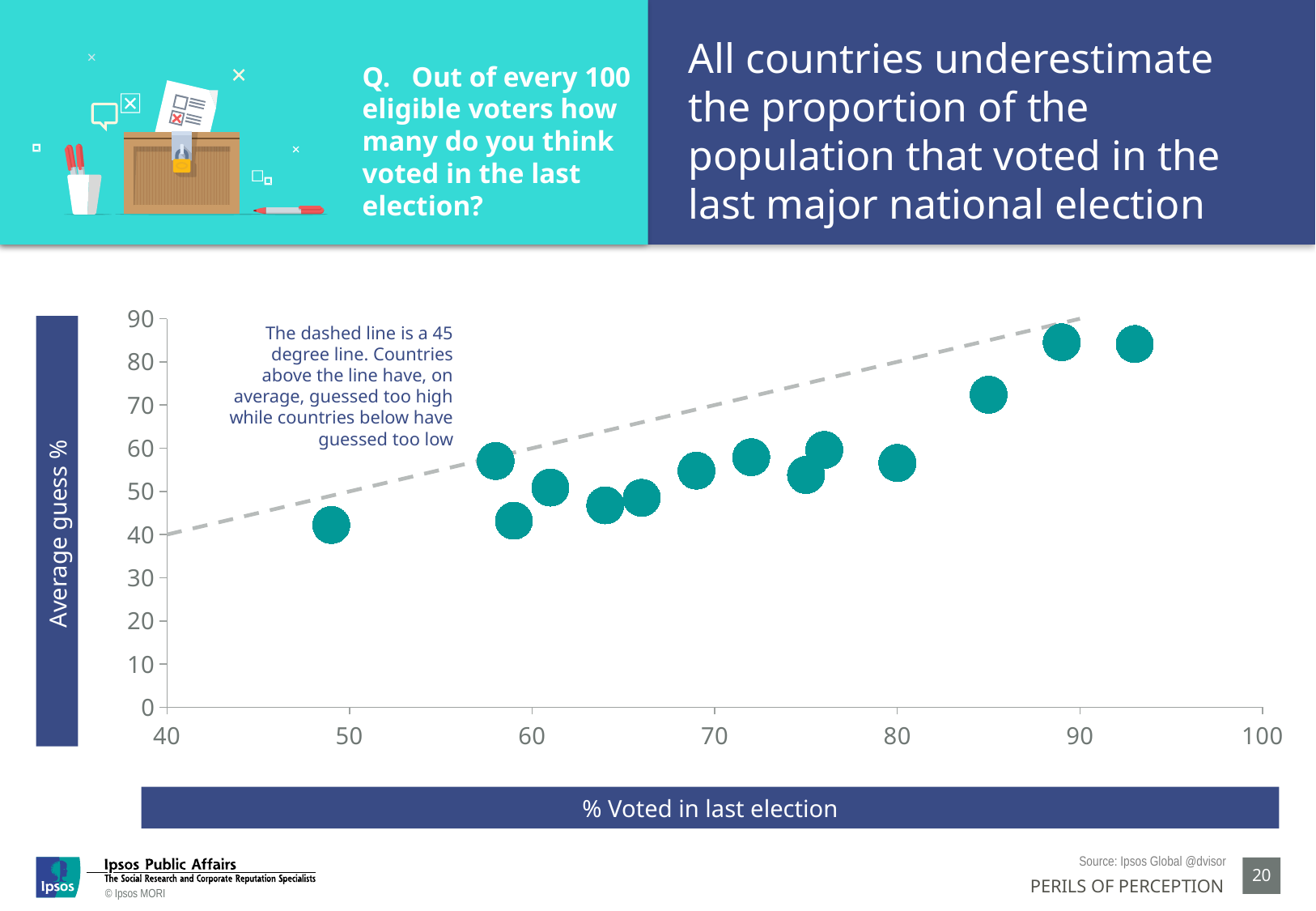
What is the title of the horizontal axis of the chart? % Voted in last election Is the average guess for the third point from the right greater or less than 80? less What kind of chart is shown on the slide? scatter chart Do the average guess values generally rise or fall as % voted in last election increases along the x axis? rise Is the average guess for the rightmost point on the chart greater or less than 80? greater Is the % voted in last election for the rightmost point greater or less than 90? greater Are the plotted points above or below the dashed 45-degree line? below How many data points are plotted on the chart? 14 Which has the higher average guess: the leftmost point or the rightmost point? the rightmost point What is the title of the vertical axis of the chart? Average guess %